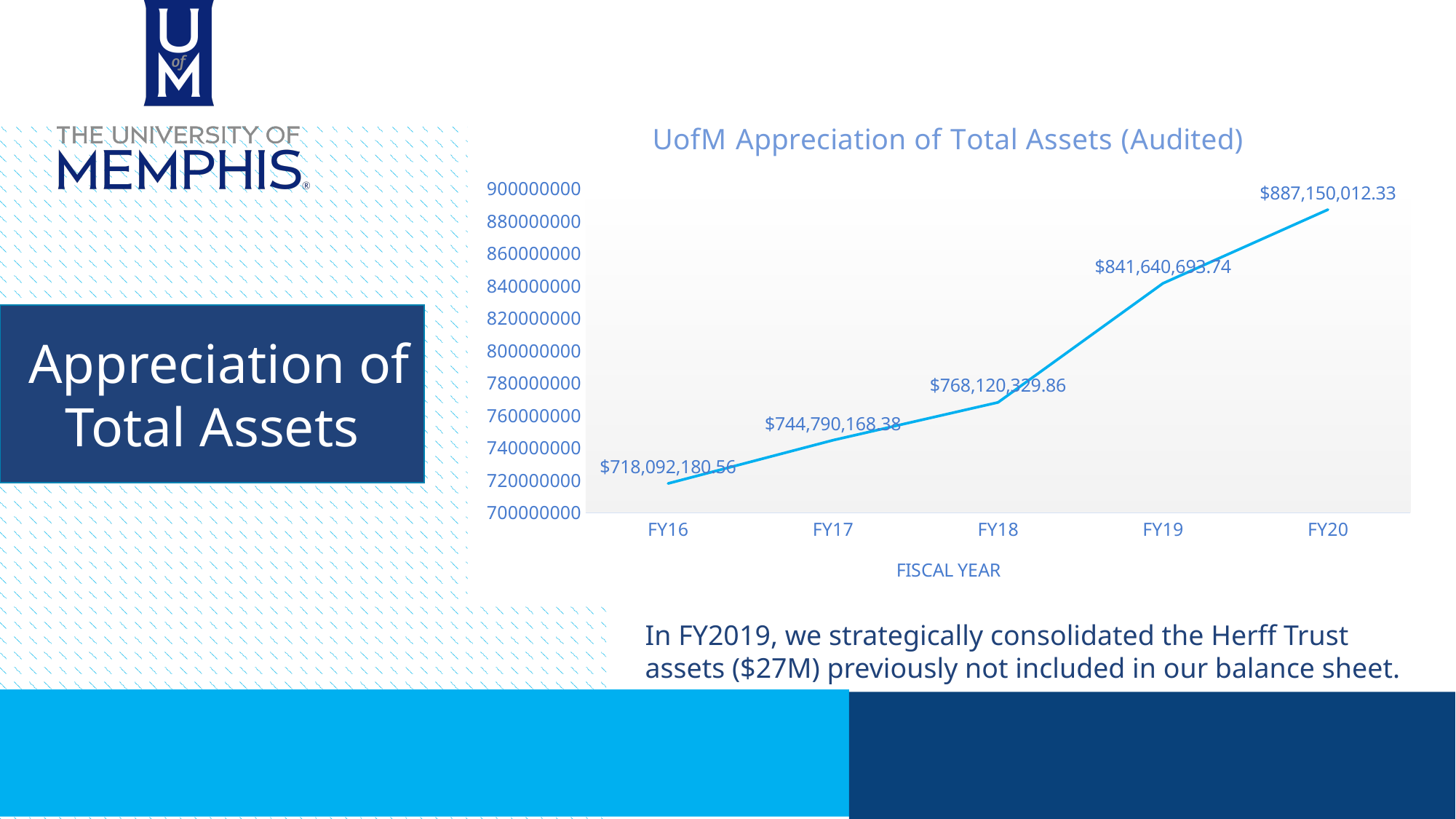
What kind of chart is shown on the slide? line chart Which fiscal year has the highest total assets? FY20 How many fiscal years are plotted on the chart? 5 What is the difference between the FY19 and FY18 values? $73,520,363.88 What is the value for FY18? $768,120,329.86 Is the value for FY19 greater or less than 820000000? greater Do the values rise or fall from FY16 to FY20? rise What is the value for FY16? $718,092,180.56 Which fiscal year has the lowest total assets? FY16 Which is larger, the value for FY17 or the value for FY19? FY19 What is the difference between the FY20 and FY19 values? $45,509,318.59 What is the value for FY20? $887,150,012.33